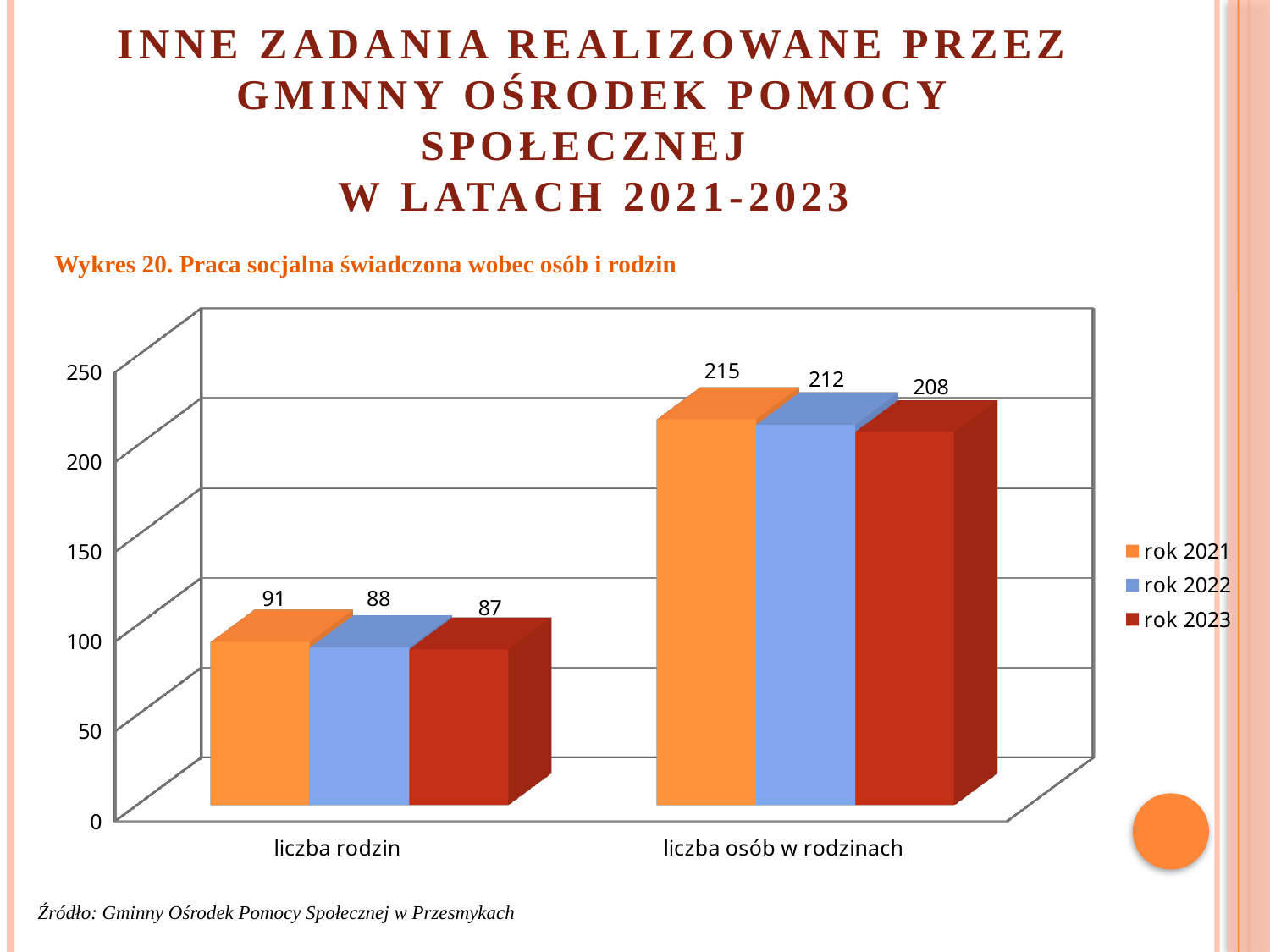
What kind of chart is shown on the slide? bar chart What is the value for 'liczba rodzin' in rok 2021? 91 What is the difference between the 'liczba osób w rodzinach' values for rok 2021 and rok 2023? 7 Do the values for 'liczba osób w rodzinach' rise or fall from rok 2021 to rok 2023? fall What is the value for 'liczba osób w rodzinach' in rok 2022? 212 Which year has the lowest value for 'liczba rodzin'? rok 2023 What is the difference between the 'liczba rodzin' values for rok 2021 and rok 2022? 3 What is the value for 'liczba rodzin' in rok 2022? 88 Which is larger: 'liczba rodzin' in rok 2021 or 'liczba rodzin' in rok 2023? rok 2021 Which year has the highest value for 'liczba osób w rodzinach'? rok 2021 How many series does the legend list? 3 What is the value for 'liczba osób w rodzinach' in rok 2023? 208